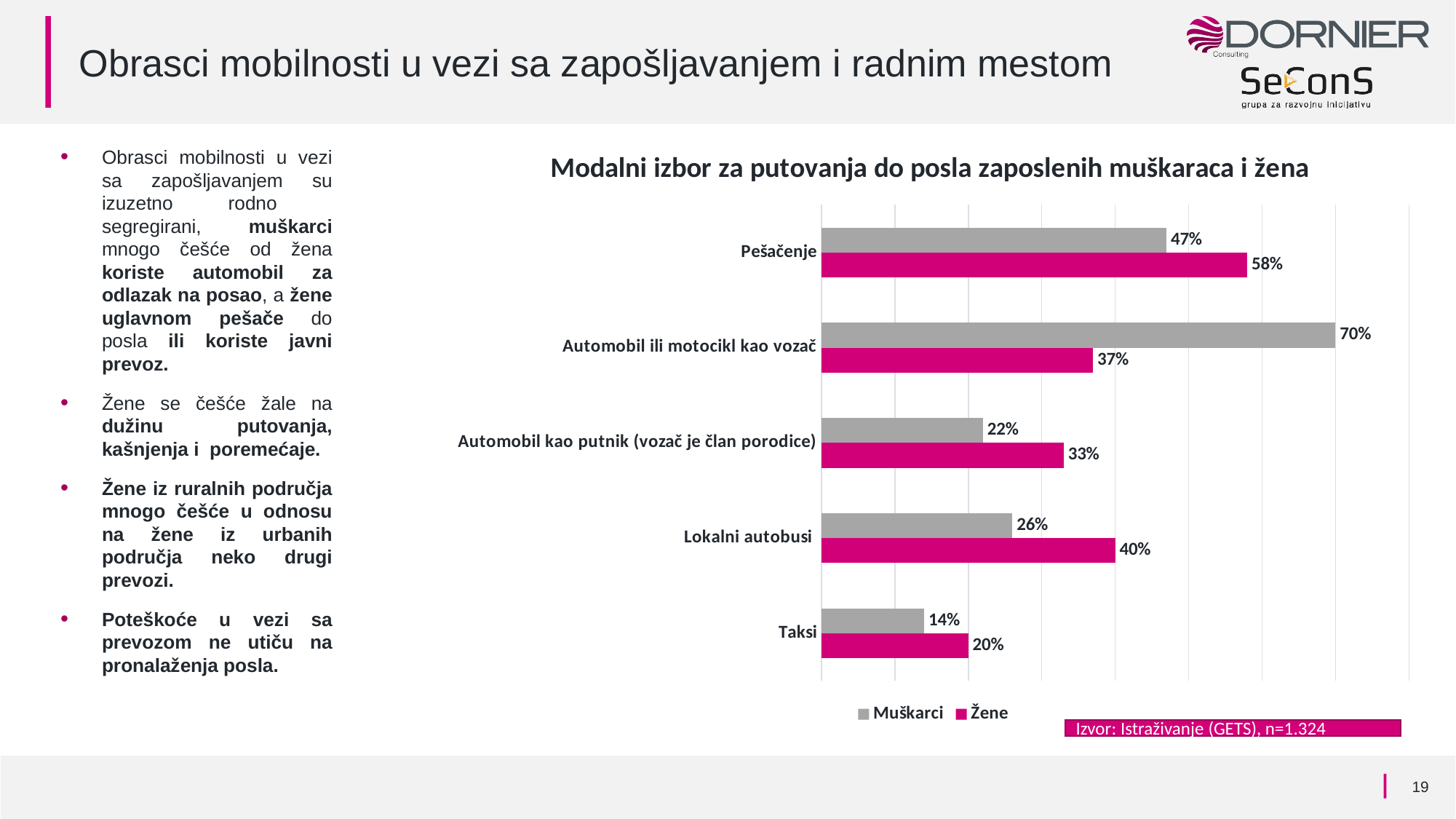
How many series does the legend list? 2 What is the value for Žene in the Pešačenje category? 58% What is the difference between the Muškarci and Žene values for Automobil ili motocikl kao vozač? 33% What is the value for Muškarci in the Taksi category? 14% Which category has the highest value for Muškarci? Automobil ili motocikl kao vozač What is the value for Žene in the Lokalni autobusi category? 40% What is the title of the chart? Modalni izbor za putovanja do posla zaposlenih muškaraca i žena Which category has the lowest value for Žene? Taksi How many categories are shown on the chart? 5 Which is larger in the Automobil kao putnik (vozač je član porodice) category, Muškarci or Žene? Žene What is the value for Muškarci in the Automobil ili motocikl kao vozač category? 70% What kind of chart is shown on the slide? Bar chart